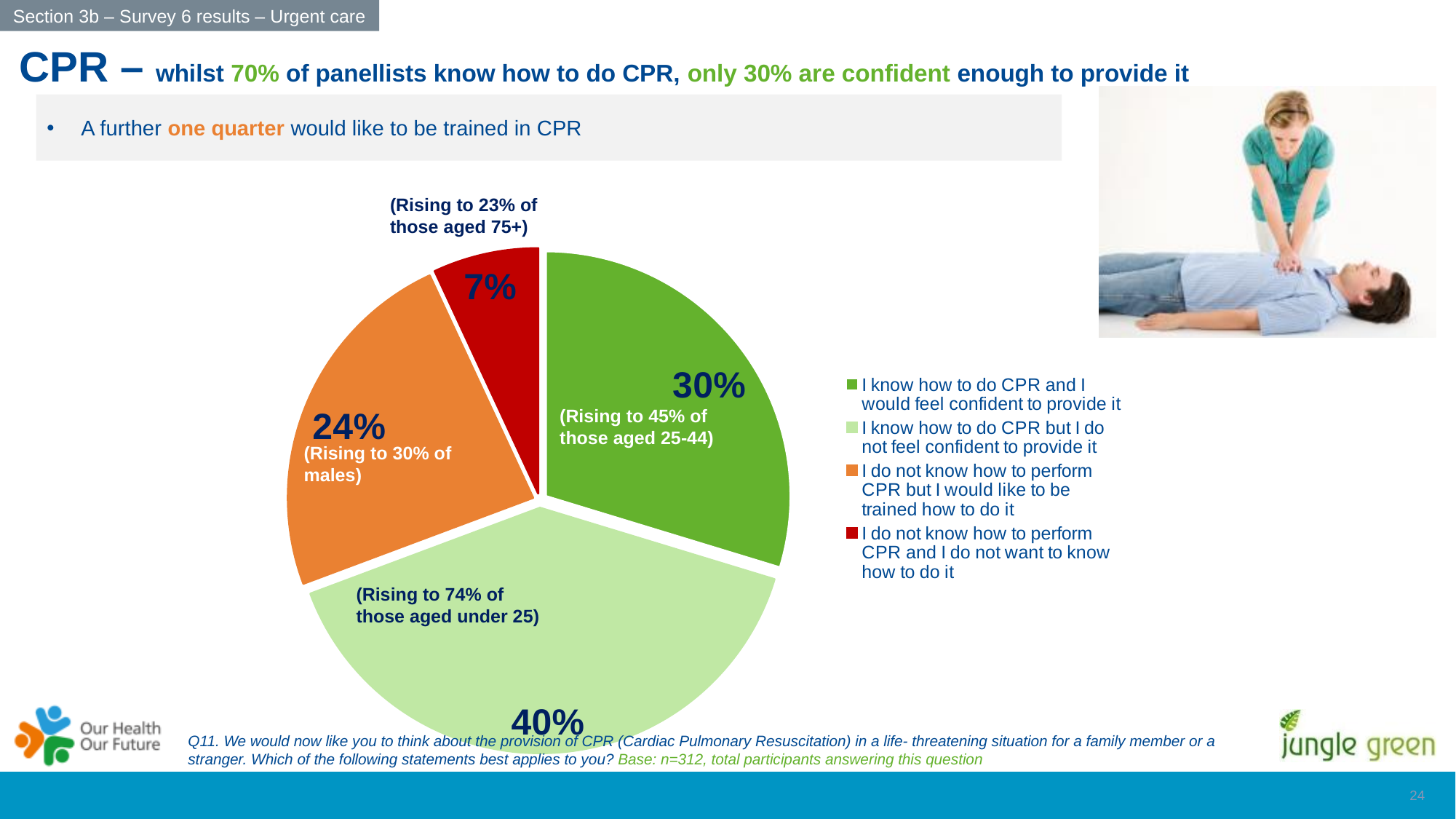
What colour is the slice for 'I do not know how to perform CPR and I do not want to know how to do it'? Red What percentage of panellists do not know how to perform CPR and do not want to know how to do it? 7% How many slices does the pie chart have? 4 What kind of chart is shown on the slide? Pie chart What percentage of panellists do not know how to perform CPR but would like to be trained how to do it? 24% How many entries does the legend list? 4 What is the difference in percentage points between those who know CPR but are not confident and those who know CPR and are confident? 10 Which response has the largest share of the pie? I know how to do CPR but I do not feel confident to provide it Which is larger: the share who would like to be trained in CPR or the share who do not want to know how to do it? The share who would like to be trained in CPR What percentage of panellists say they know how to do CPR but do not feel confident to provide it? 40% Which response has the smallest share of the pie? I do not know how to perform CPR and I do not want to know how to do it What percentage of panellists say they know how to do CPR and would feel confident to provide it? 30%